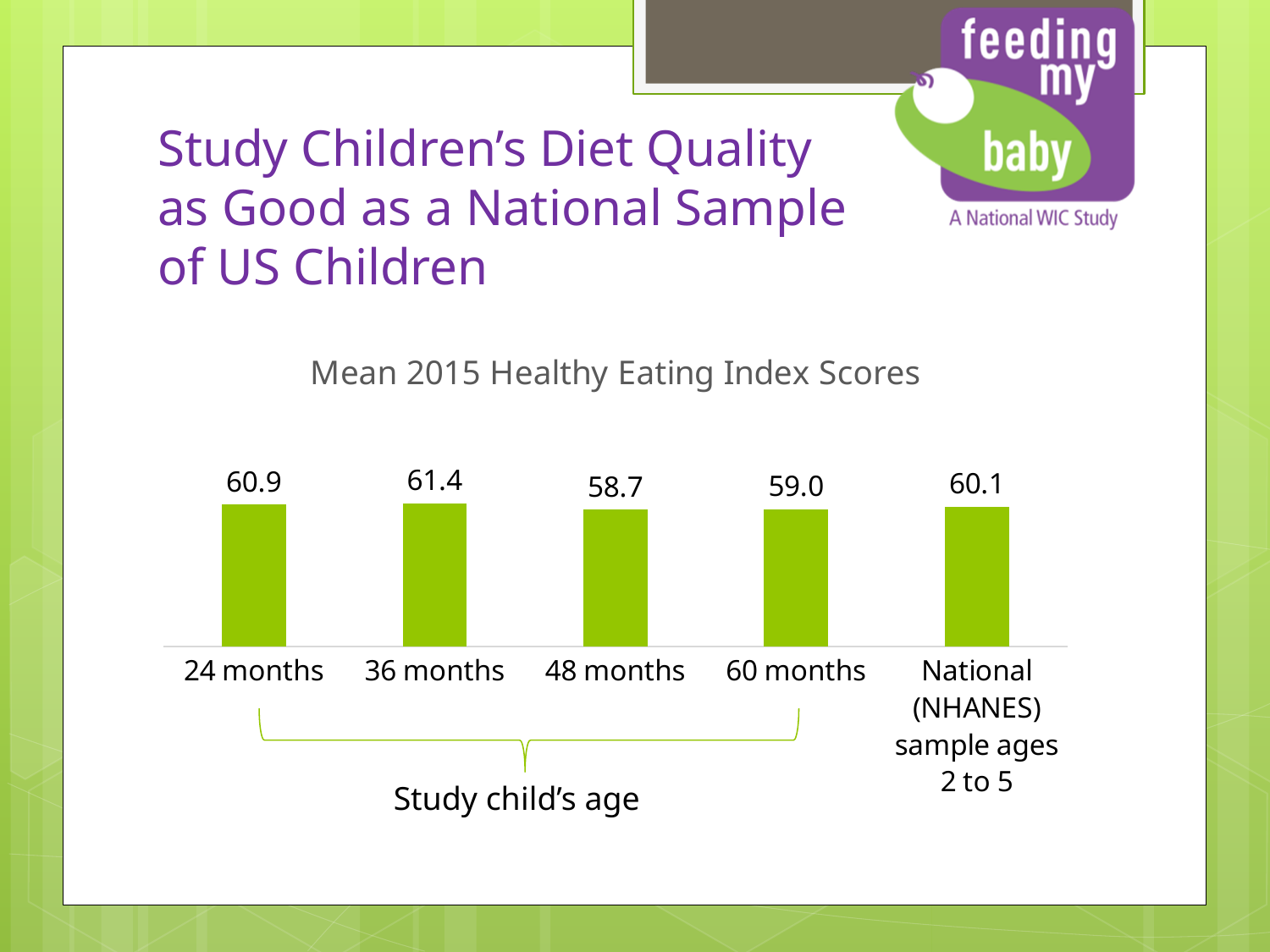
What is the title of the chart? Mean 2015 Healthy Eating Index Scores What is the mean 2015 Healthy Eating Index score for study children at 24 months? 60.9 What is the mean 2015 Healthy Eating Index score for study children at 48 months? 58.7 What kind of chart is shown on the slide? Bar chart Which category has the highest mean 2015 Healthy Eating Index score? 36 months Which category has the lowest mean 2015 Healthy Eating Index score? 48 months What is the mean 2015 Healthy Eating Index score for the National (NHANES) sample ages 2 to 5? 60.1 What is the difference between the mean Healthy Eating Index scores at 36 months and 48 months? 2.7 What is the mean 2015 Healthy Eating Index score for study children at 36 months? 61.4 Which has a higher mean Healthy Eating Index score, 60 months or the National (NHANES) sample ages 2 to 5? National (NHANES) sample ages 2 to 5 What is the difference between the mean Healthy Eating Index score at 24 months and the National (NHANES) sample score? 0.8 How many bars are shown in the chart? 5